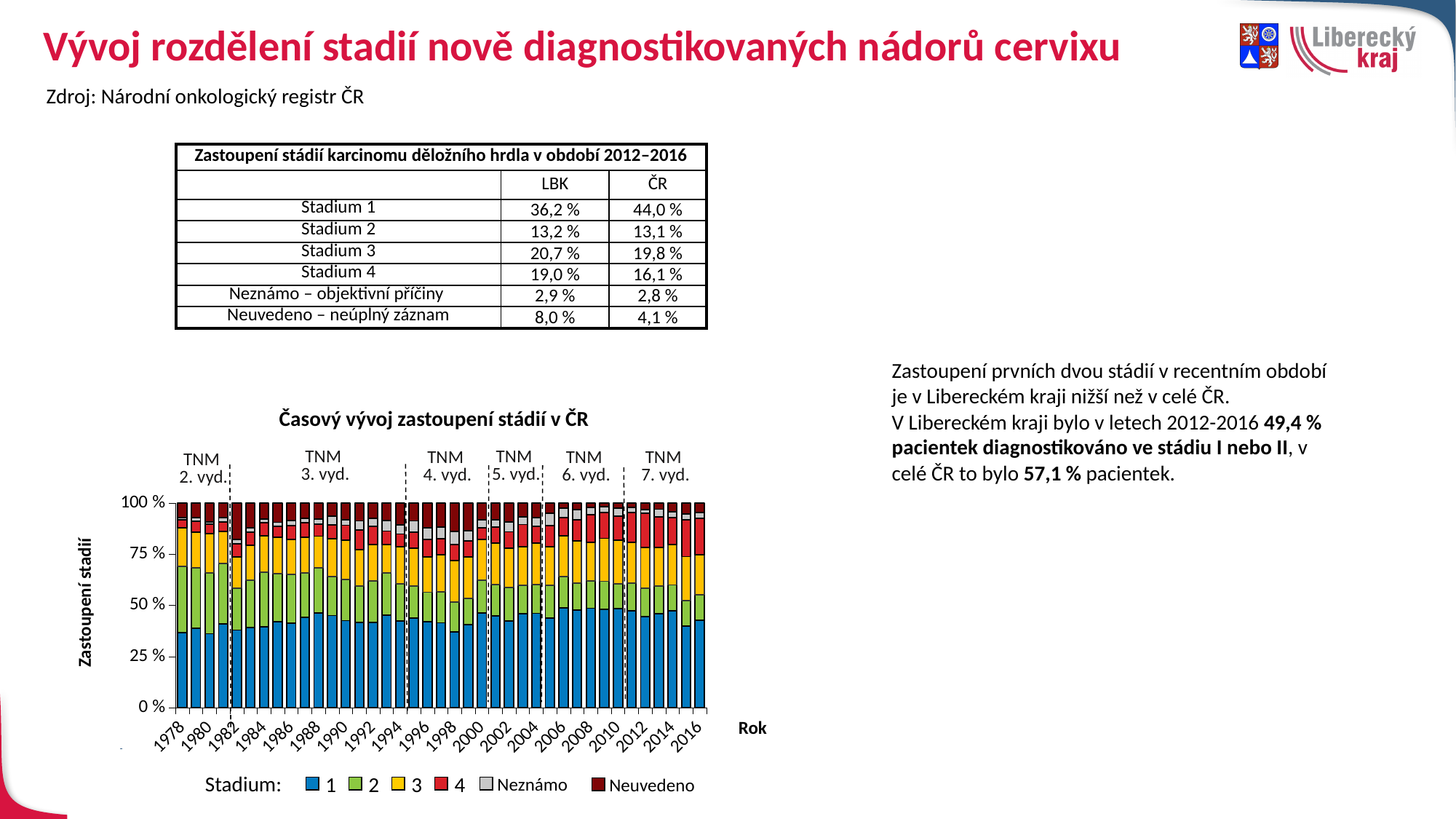
What is the label of the x axis of the chart? Rok Which stages and categories are listed in the chart legend? 1, 2, 3, 4, Neznámo, Neuvedeno How many years (bars) are plotted in the chart, from 1978 to 2016? 39 Does the share of Stadium 4 generally rise or fall from 1978 to 2016? rise Is the value for Stadium 1 in 1998 greater or less than 50 %? less Does the share of Neuvedeno generally rise or fall from 1978 to 2016? fall How many series does the legend of the chart list? 6 What kind of chart is "Časový vývoj zastoupení stádií v ČR"? Stacked bar chart In 1978, which is larger: the share of Stadium 1 or the share of Stadium 4? Stadium 1 Is the value for Stadium 1 in 1978 greater or less than 50 %? less Is the value for Stadium 1 in 2016 greater or less than 25 %? greater What is the total of the stacked bar for the year 2016? 100 %